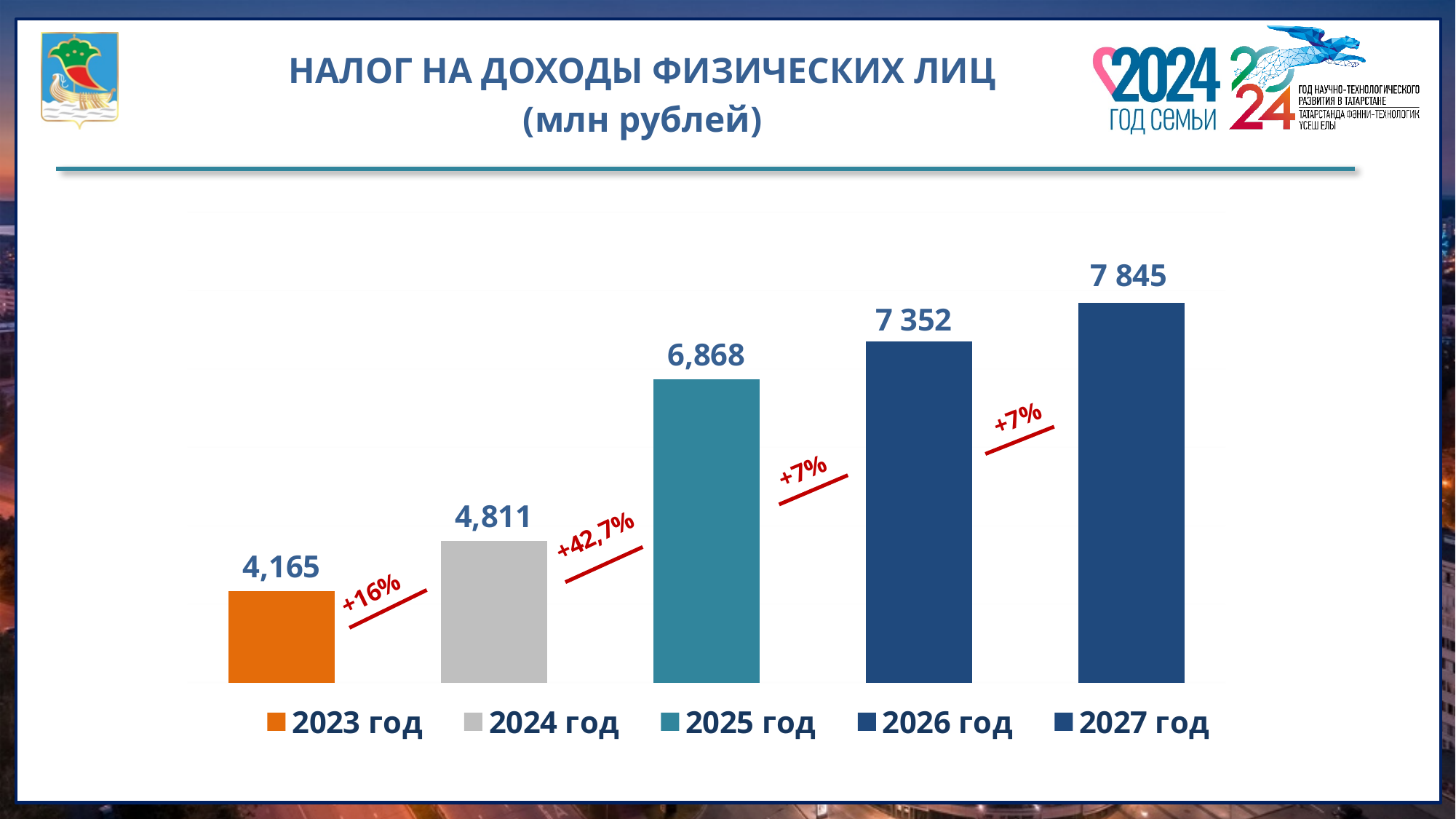
How many entries does the legend list? 5 What is the difference between the values for 2027 год and 2026 год? 493 What kind of chart is shown on the slide? bar chart What is the value for 2027 год? 7 845 Which year has the lowest value? 2023 год Which year has the highest value? 2027 год Do the values rise or fall from 2023 год to 2027 год? rise Which is larger, the value for 2025 год or the value for 2024 год? 2025 год What is the value for 2023 год? 4,165 What is the value for 2025 год? 6,868 How many bars are shown in the chart? 5 What is the difference between the values for 2024 год and 2023 год? 646